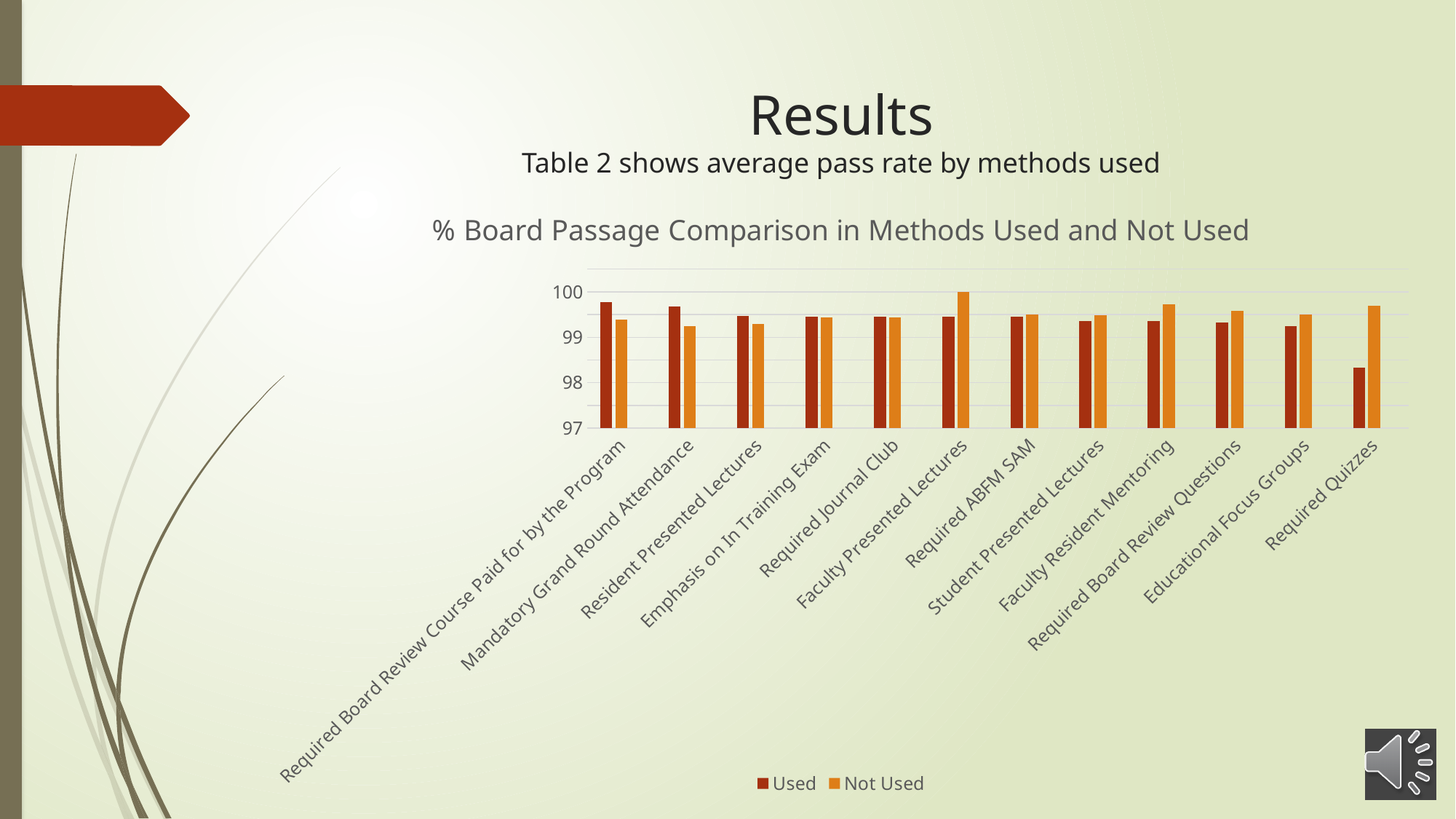
Is the Used value for Required Quizzes greater or less than 99? less How many series does the legend list? 2 For Required Quizzes, which is larger: the Used value or the Not Used value? Not Used Which method has the highest value in the Not Used series? Faculty Presented Lectures Is the Used value for Required Board Review Course Paid for by the Program greater or less than 99? greater Which method has the lowest value in the Used series? Required Quizzes What are the two series named in the legend? Used and Not Used What kind of chart is shown on the slide? bar chart For Mandatory Grand Round Attendance, which is larger: the Used value or the Not Used value? Used Is the Used value for Required Quizzes greater or less than 98? greater How many methods (categories) are shown on the x axis? 12 What is the title of the chart? % Board Passage Comparison in Methods Used and Not Used